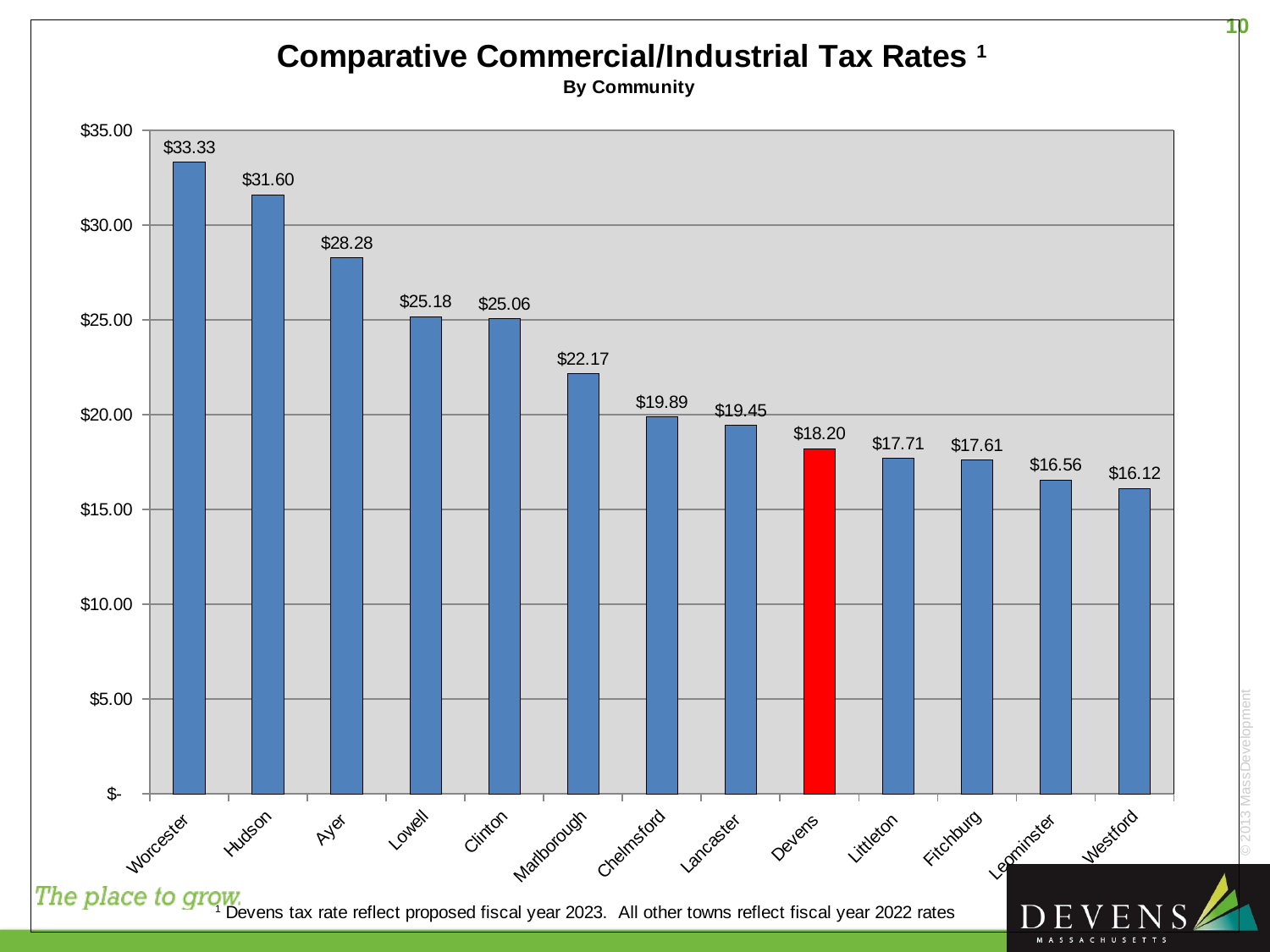
What kind of chart is shown on the slide? Bar chart Which community has the lowest tax rate on the chart? Westford How many communities are shown on the chart? 13 Is the tax rate for Chelmsford greater or less than $20.00? less Do the tax rates rise or fall moving from left to right across the chart? Fall What is the commercial/industrial tax rate shown for Devens? $18.20 What is the difference between the tax rates of Worcester and Hudson? $1.73 What is the difference between the tax rates of Devens and Westford? $2.08 Which community has the highest tax rate on the chart? Worcester Which has a higher tax rate, Ayer or Lowell? Ayer Which community's bar is coloured red instead of blue? Devens What is the tax rate shown for Marlborough? $22.17